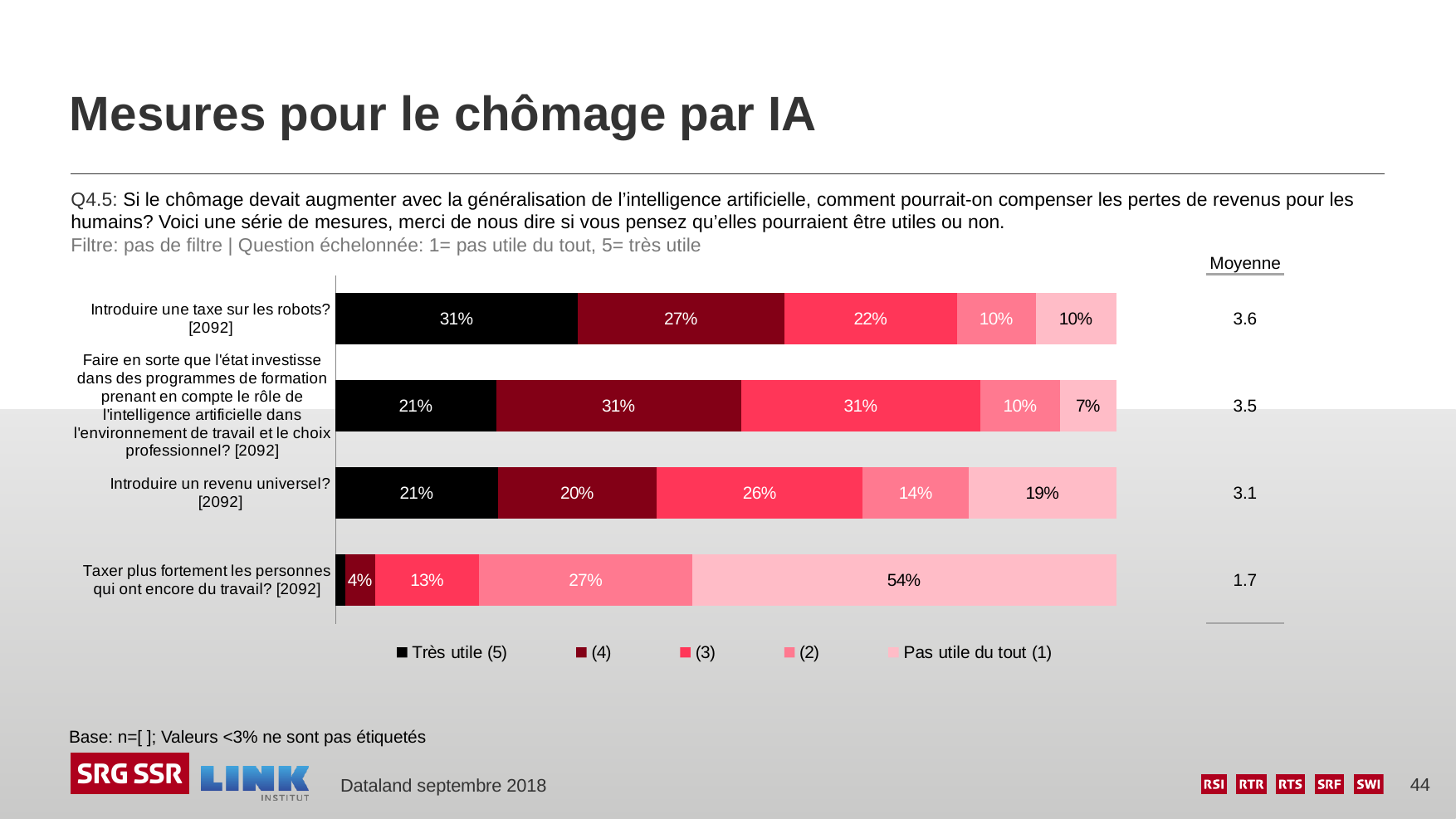
Which measure has the lowest Moyenne? Taxer plus fortement les personnes qui ont encore du travail? What percentage of respondents rated "Introduire une taxe sur les robots?" as Très utile (5)? 31% Which has the larger Pas utile du tout (1) share: "Introduire un revenu universel?" or "Introduire une taxe sur les robots?"? Introduire un revenu universel? Which measure has the highest Moyenne? Introduire une taxe sur les robots? What percentage of respondents rated "Taxer plus fortement les personnes qui ont encore du travail?" as Pas utile du tout (1)? 54% How many measures (bars) are shown in the chart? 4 How many percentage points higher is the Très utile (5) share for "Introduire une taxe sur les robots?" than for "Introduire un revenu universel?"? 10 percentage points What colour represents Très utile (5) in the chart? Black How many series does the legend list? 5 What kind of chart is shown on the slide? Stacked bar chart What is the Moyenne shown for "Introduire une taxe sur les robots?"? 3.6 What is the (3) value for "Introduire un revenu universel?"? 26%